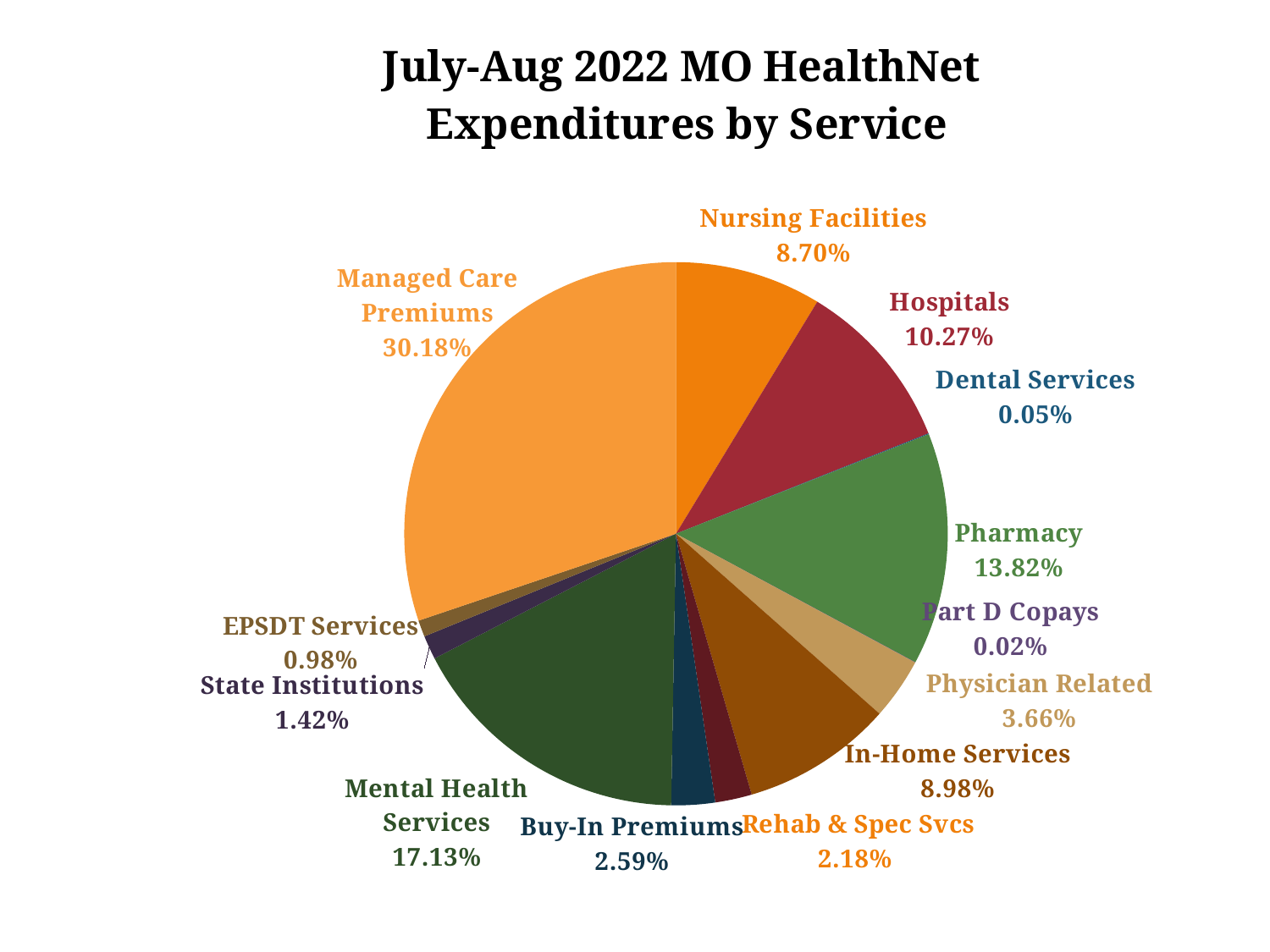
Which service has the largest share of expenditures? Managed Care Premiums What kind of chart is shown on the slide? pie chart What is the value for In-Home Services? 8.98% What is the combined share of Buy-In Premiums and Rehab & Spec Svcs? 4.77% What percentage is shown for Pharmacy? 13.82% What is the difference between the Mental Health Services share and the Hospitals share? 6.86% Which service has the smallest share of expenditures? Part D Copays Which is larger, Nursing Facilities or In-Home Services? In-Home Services What is the title of the chart? July-Aug 2022 MO HealthNet Expenditures by Service What share of expenditures is Managed Care Premiums? 30.18% How many service categories are shown in the pie chart? 13 What percentage is shown for Dental Services? 0.05%